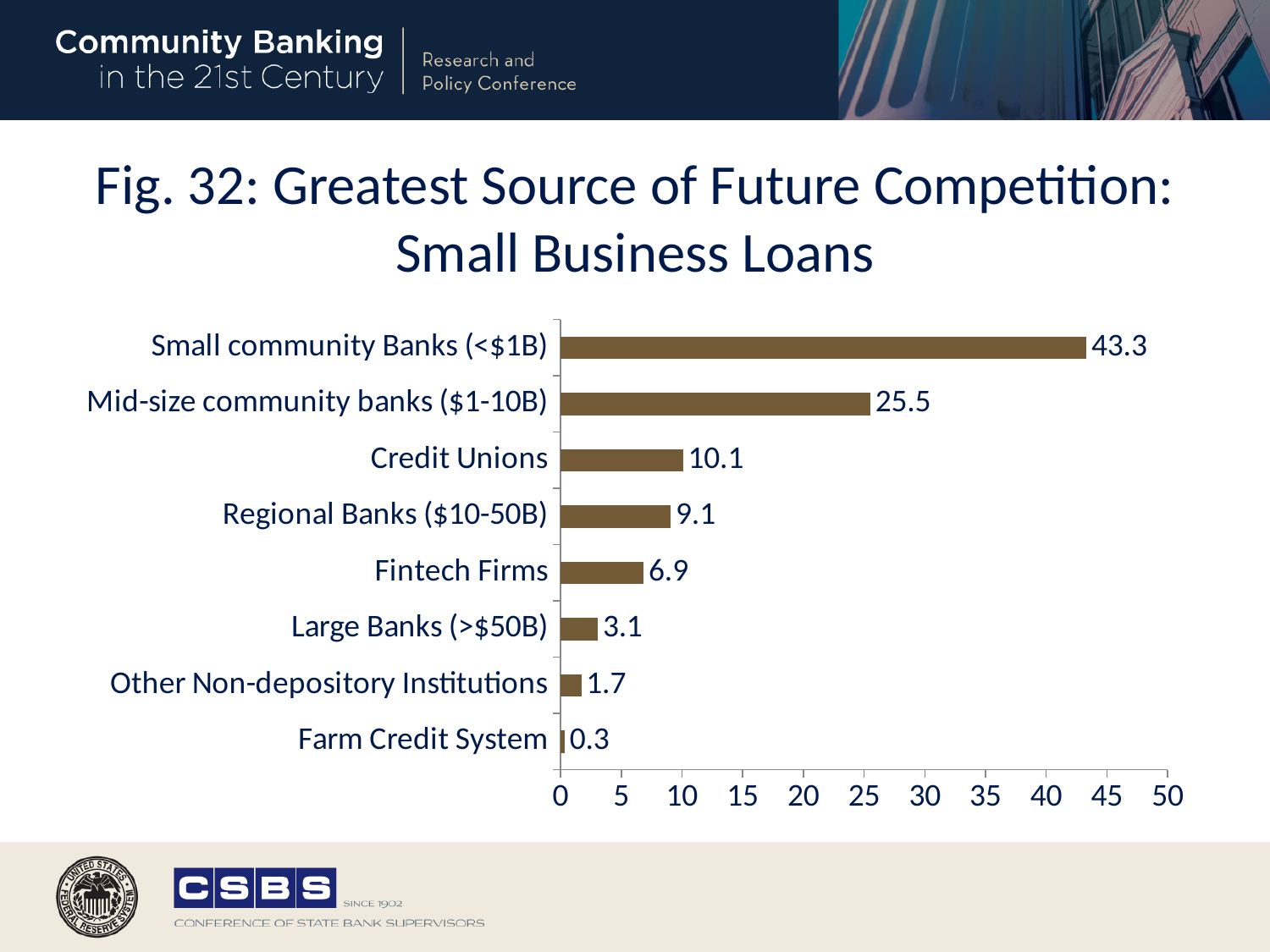
What is the title of the chart? Fig. 32: Greatest Source of Future Competition: Small Business Loans Which category has the highest value? Small community Banks (<$1B) What is the difference between the values for Small community Banks (<$1B) and Mid-size community banks ($1-10B)? 17.8 What is the value for Large Banks (>$50B)? 3.1 How many categories are shown in the chart? 8 Which category has the lowest value? Farm Credit System What is the value for Fintech Firms? 6.9 What kind of chart is shown on the slide? Bar chart Which is larger, the value for Credit Unions or the value for Regional Banks ($10-50B)? Credit Unions Is the value for Mid-size community banks ($1-10B) greater or less than 20? greater What is the difference between the values for Fintech Firms and Large Banks (>$50B)? 3.8 What is the value for Credit Unions? 10.1